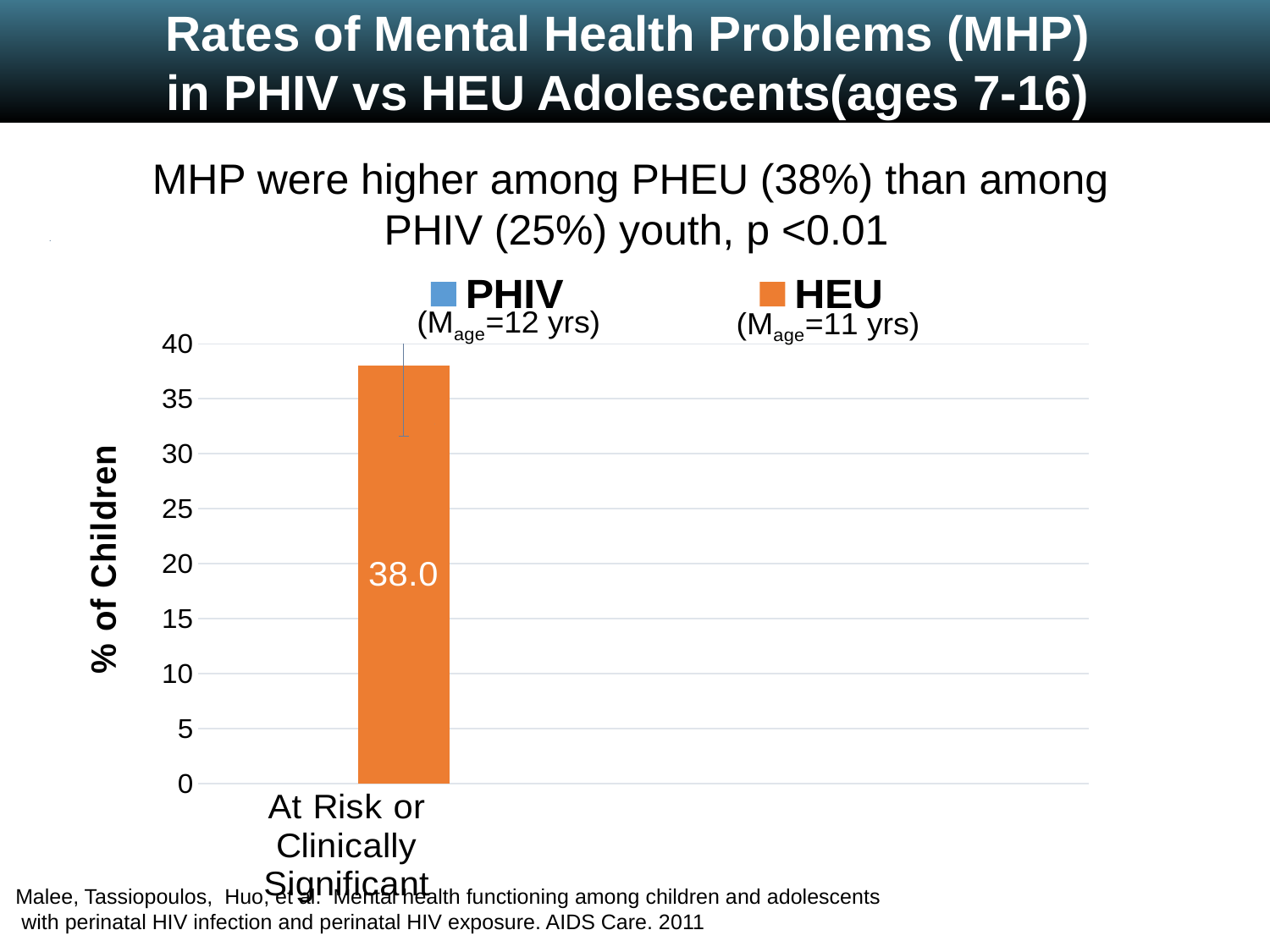
How many categories are shown on the x axis of the chart? 1 What is the maximum value shown on the y axis? 40 Is the value of the HEU bar greater or less than 40? less Is the value of the HEU bar greater or less than 35? greater What is the label of the category on the x axis? At Risk or Clinically Significant What is the title of the y axis? % of Children What is the value of the HEU bar for the 'At Risk or Clinically Significant' category? 38.0 What kind of chart is shown on the slide? bar chart How many series does the chart legend list? 2